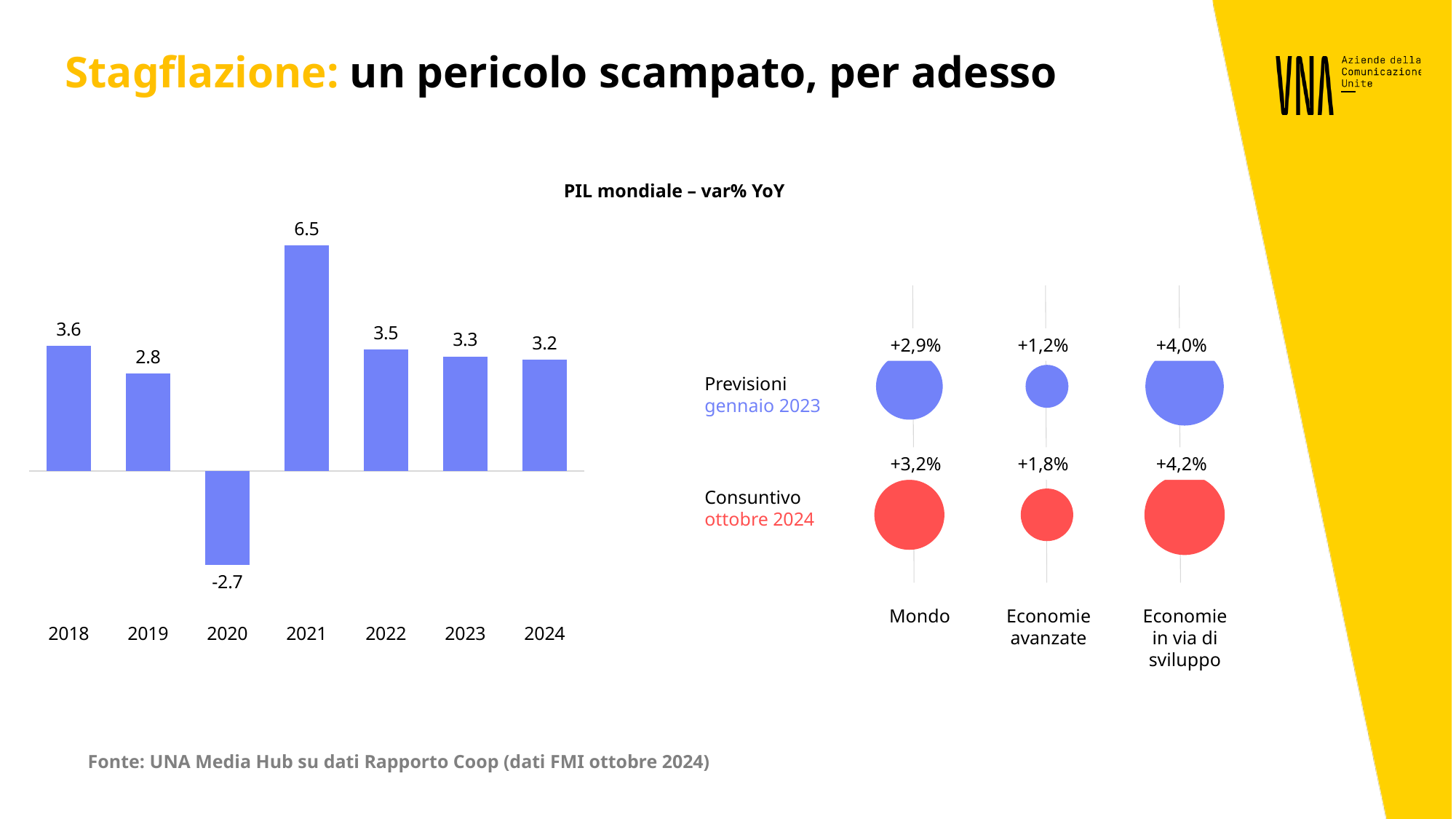
In the bar chart 'PIL mondiale – var% YoY', do the values rise or fall from 2022 to 2024? fall In the bar chart 'PIL mondiale – var% YoY', which year has the highest value? 2021 In the bar chart 'PIL mondiale – var% YoY', which is larger, the value for 2018 or the value for 2019? 2018 In the bar chart 'PIL mondiale – var% YoY', which year has the lowest value? 2020 How many years are shown in the bar chart 'PIL mondiale – var% YoY'? 7 In the bar chart 'PIL mondiale – var% YoY', what is the value for 2020? -2.7 In the bar chart 'PIL mondiale – var% YoY', what is the difference between the values for 2021 and 2022? 3.0 What kind of chart is 'PIL mondiale – var% YoY'? bar chart In the bar chart 'PIL mondiale – var% YoY', what is the value for 2021? 6.5 In the bubble chart on the right, what is the 'Previsioni gennaio 2023' value for Economie avanzate? +1,2% In the bubble chart on the right, what is the 'Consuntivo ottobre 2024' value for Mondo? +3,2% In the bubble chart on the right, which category has the highest 'Consuntivo ottobre 2024' value? Economie in via di sviluppo